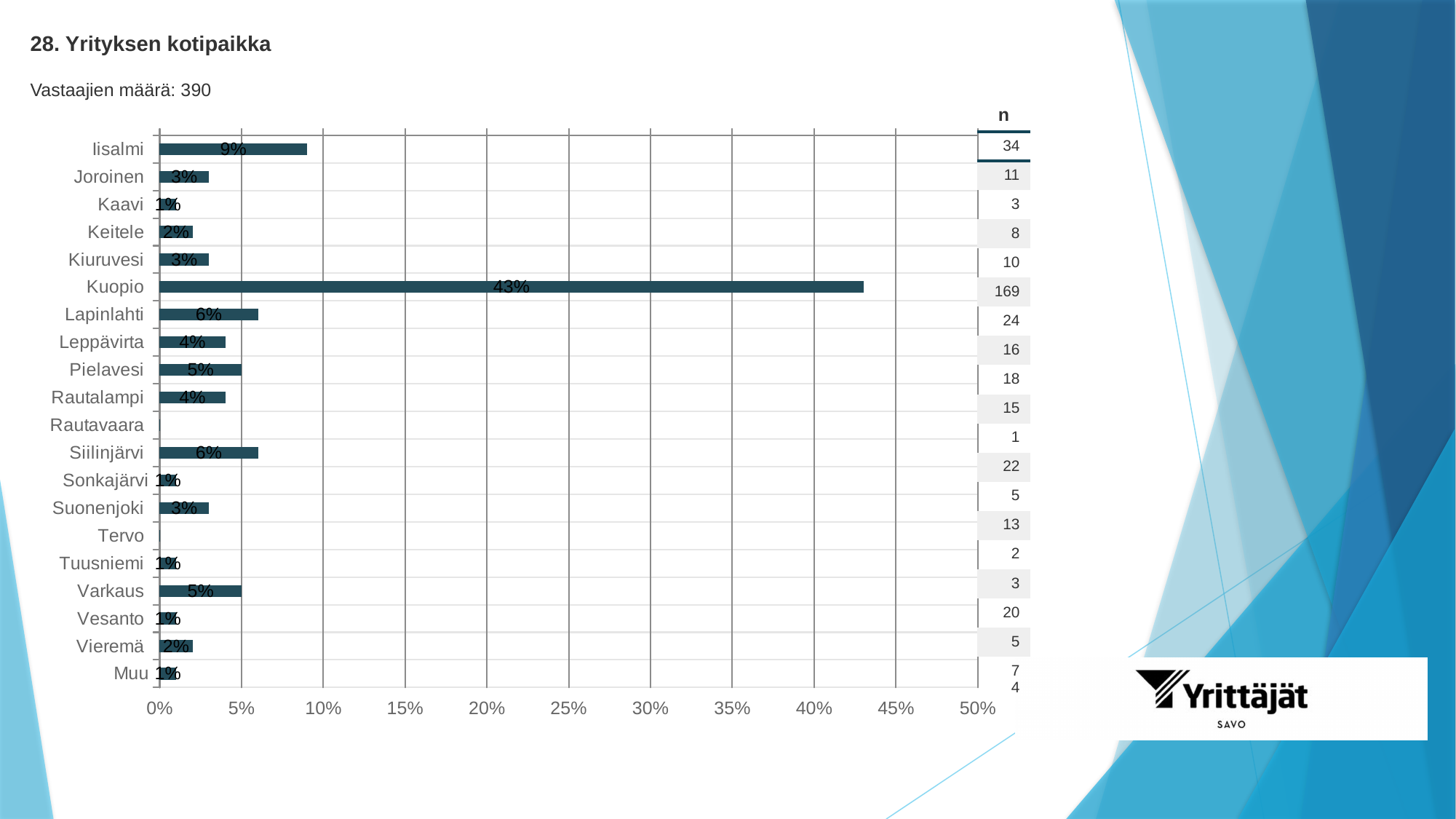
What is the number of respondents (Vastaajien määrä) stated on the slide? 390 What is the value for Iisalmi? 9% What is the title of the slide? 28. Yrityksen kotipaikka What is the value for Varkaus? 5% What is the value for Lapinlahti? 6% Which is larger, the value for Pielavesi or the value for Leppävirta? Pielavesi What is the value for Kuopio? 43% What kind of chart is shown on the slide? bar chart Is the value for Kuopio greater or less than 40%? greater How many categories are shown on the y axis of the chart? 20 What is the difference between the values for Kuopio and Iisalmi? 34% Which category has the highest value? Kuopio